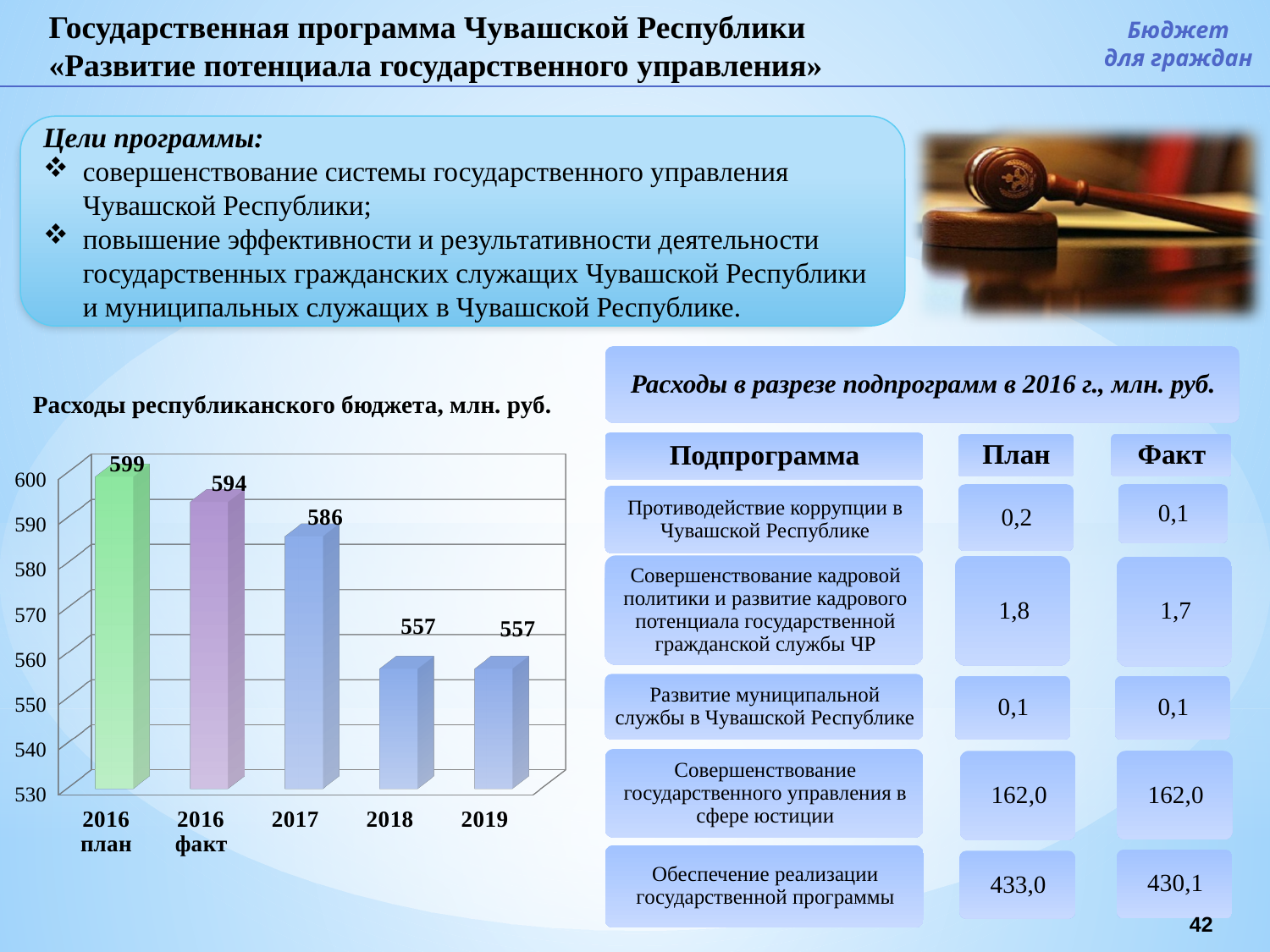
What is the value for '2016 план' in the chart? 599 Which is larger, the value for '2016 факт' or the value for 2017? 2016 факт What is the difference between the values for '2016 план' and '2016 факт'? 5 What kind of chart is shown on the slide? bar chart What is the value for '2016 факт' in the chart? 594 How many categories are shown on the x axis of the chart? 5 Is the value for 2018 greater or less than 560? less Which category has the highest value in the chart? 2016 план What is the value for 2019 in the chart? 557 What is the difference between the values for 2017 and 2018? 29 Do the values in the chart rise or fall from '2016 план' to 2018? fall What is the value for 2017 in the chart 'Расходы республиканского бюджета, млн. руб.'? 586